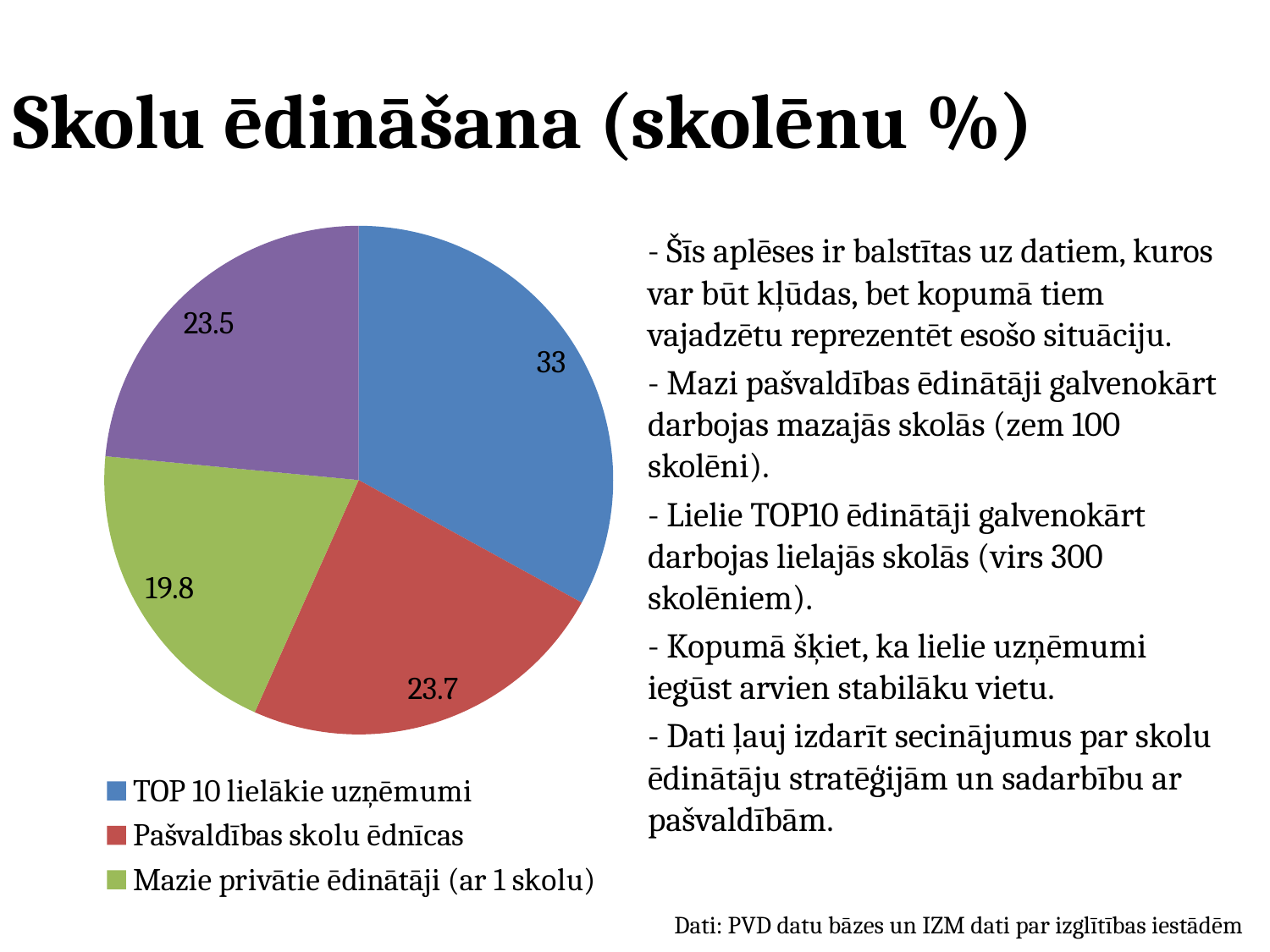
What type of chart is shown on the slide? pie chart What is the value for Mazie privātie ēdinātāji (ar 1 skolu)? 19.8 What is the difference between the values for TOP 10 lielākie uzņēmumi and Pašvaldības skolu ēdnīcas? 9.3 What is the value for Pašvaldības skolu ēdnīcas? 23.7 Which category has the largest slice of the pie? TOP 10 lielākie uzņēmumi What is the difference between the values for Pašvaldības skolu ēdnīcas and Mazie privātie ēdinātāji (ar 1 skolu)? 3.9 How many slices does the pie chart have? 4 What colour is the slice for Pašvaldības skolu ēdnīcas? red How many entries does the legend list? 3 Which slice of the pie is the smallest? Mazie privātie ēdinātāji (ar 1 skolu) Which is larger, the value for TOP 10 lielākie uzņēmumi or the value for Mazie privātie ēdinātāji (ar 1 skolu)? TOP 10 lielākie uzņēmumi What is the value for TOP 10 lielākie uzņēmumi? 33